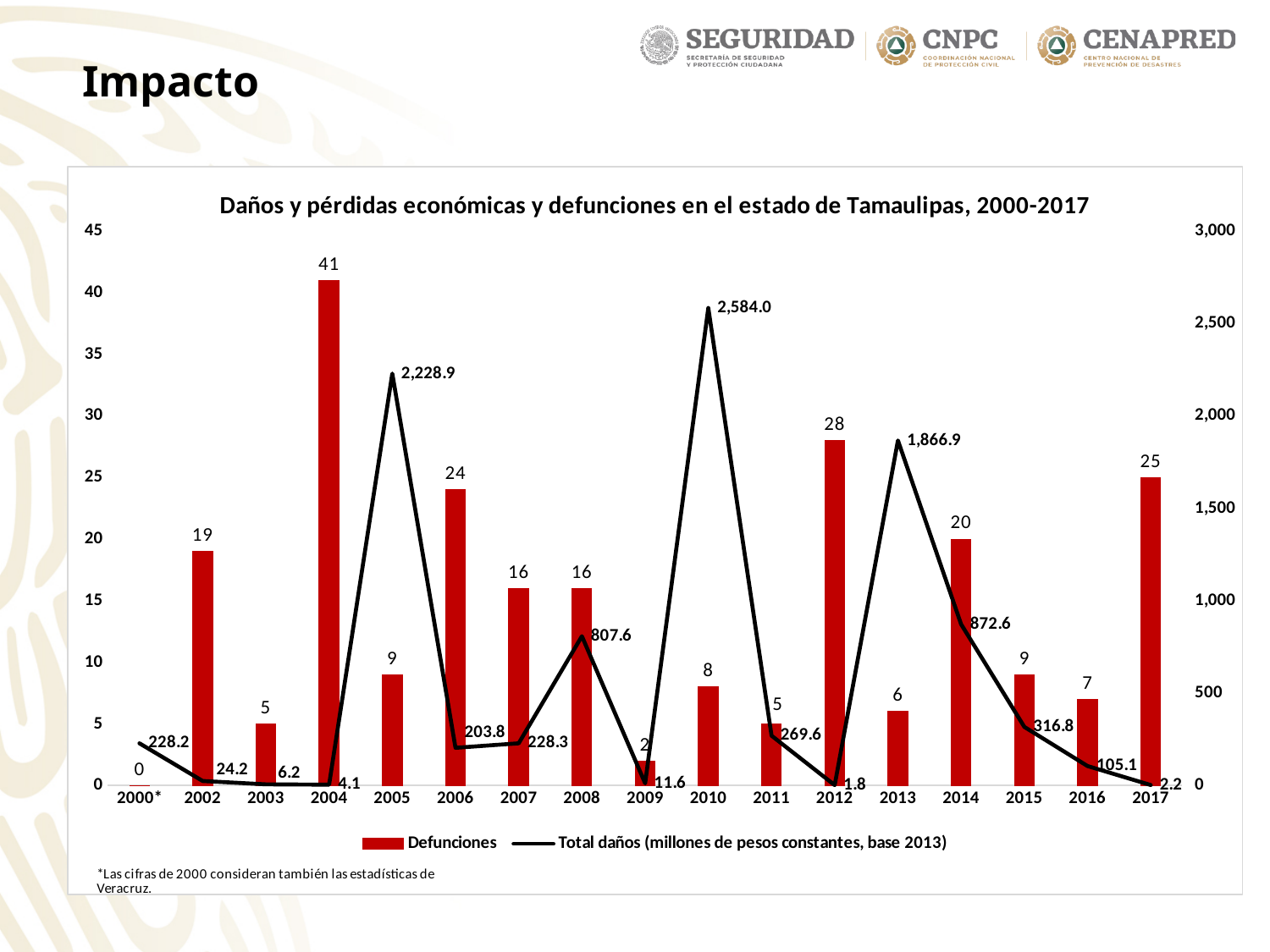
Do the Total daños values rise or fall from 2013 to 2017? Fall Which year has the highest number of Defunciones? 2004 What is the title of the chart? Daños y pérdidas económicas y defunciones en el estado de Tamaulipas, 2000-2017 What is the difference in Defunciones between 2012 and 2013? 22 How many series does the legend list? 2 What is the value of Defunciones for 2004? 41 What is the Total daños value for 2010? 2,584.0 How many years are shown on the x axis? 17 Which year has the lowest Total daños value? 2012 Which is larger, the Total daños value for 2013 or for 2014? 2013 What kind of chart is used for the Defunciones series? Bar chart What is the Total daños value for 2005? 2,228.9